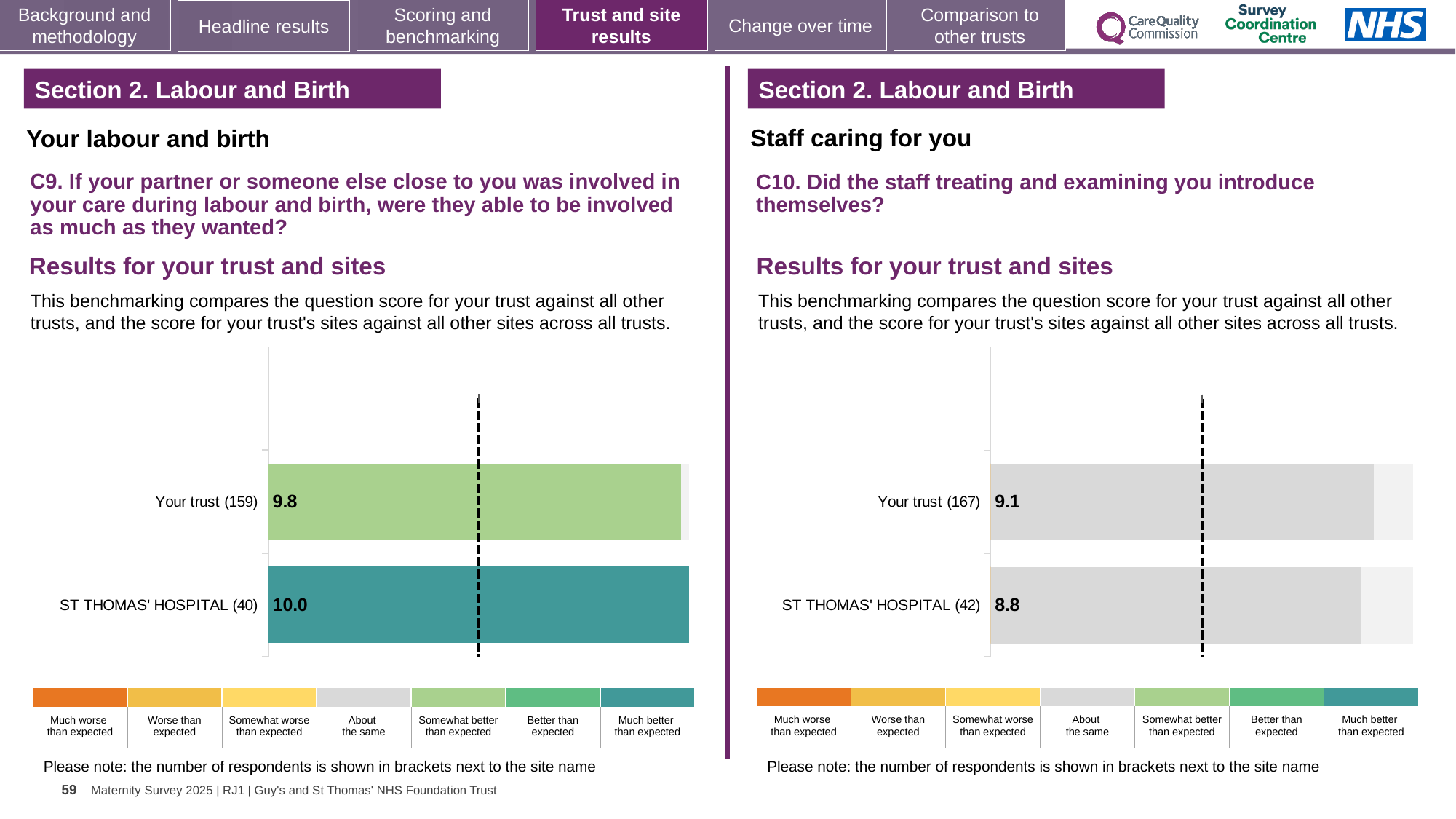
In the left chart (C9), which has the higher score, Your trust or ST THOMAS' HOSPITAL? ST THOMAS' HOSPITAL In the right chart (C10), what is the difference between the Your trust score and the ST THOMAS' HOSPITAL score? 0.3 In the left chart (C9), how many respondents are shown in brackets for ST THOMAS' HOSPITAL? 40 In the right chart (C10), what is the score for ST THOMAS' HOSPITAL? 8.8 In the right chart (C10), how many respondents are shown in brackets for Your trust? 167 In the right chart (C10), what is the score for Your trust? 9.1 How many bars are plotted in the left chart (C9)? 2 In the left chart (C9), what is the score for ST THOMAS' HOSPITAL? 10.0 In the right chart (C10), which has the lower score, Your trust or ST THOMAS' HOSPITAL? ST THOMAS' HOSPITAL In the left chart (C9), what is the score for Your trust? 9.8 What type of chart is used on the right side of the slide (C10)? Bar chart In the left chart (C9), what is the difference between the ST THOMAS' HOSPITAL score and the Your trust score? 0.2